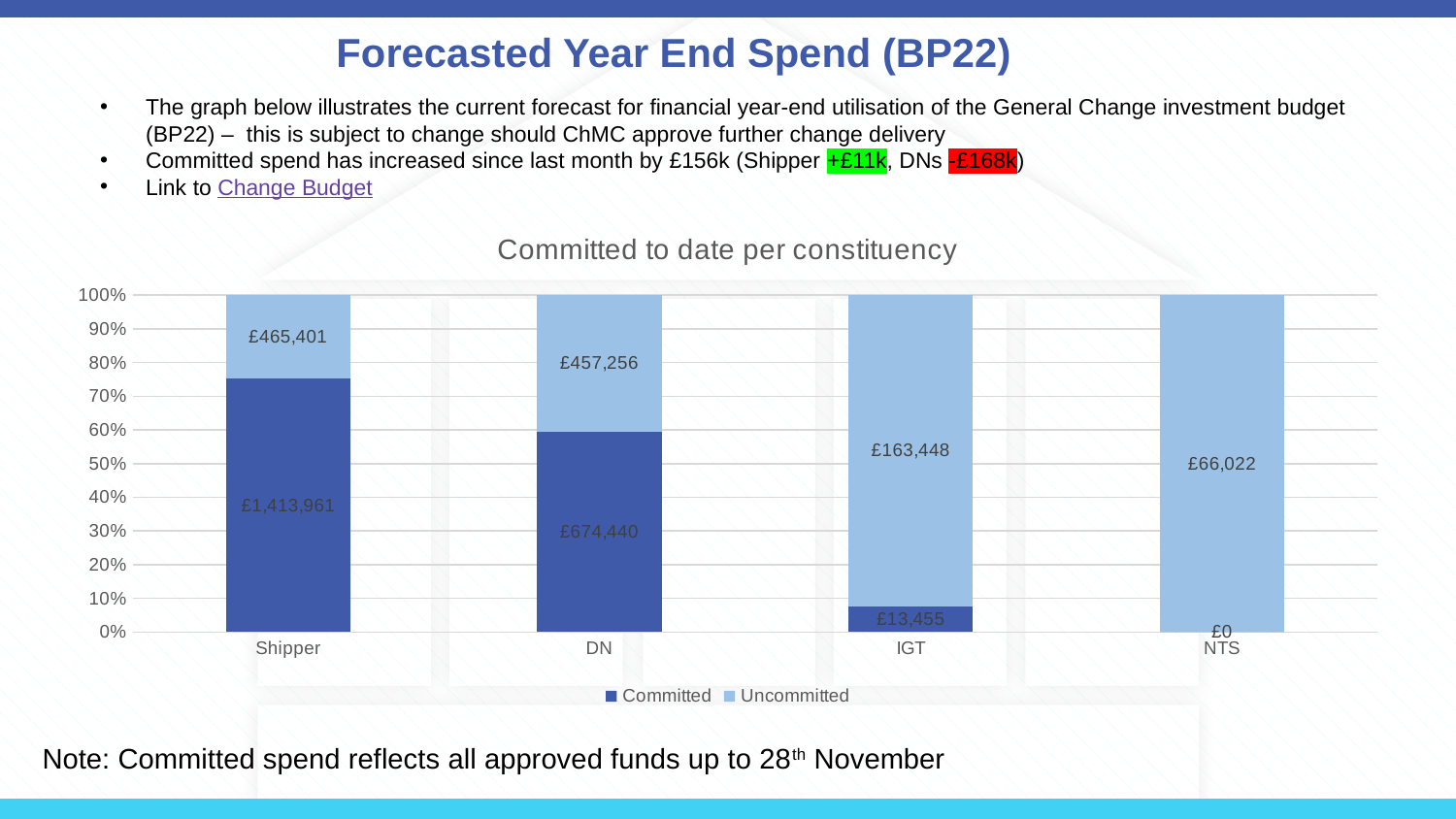
What is the Committed value for NTS? £0 Which is larger, the Uncommitted value for Shipper or the Uncommitted value for IGT? Shipper Which constituency has the lowest Uncommitted value? NTS Is the Committed share of the Shipper bar greater or less than 70%? greater What is the Committed value for Shipper? £1,413,961 Which constituency has the highest Committed value? Shipper What is the difference between the Committed values for Shipper and DN? £739,521 What is the Committed value for IGT? £13,455 What is the total of the Committed and Uncommitted values for DN? £1,131,696 How many constituencies are shown on the x axis? 4 How many series does the legend list? 2 What is the Uncommitted value for DN? £457,256